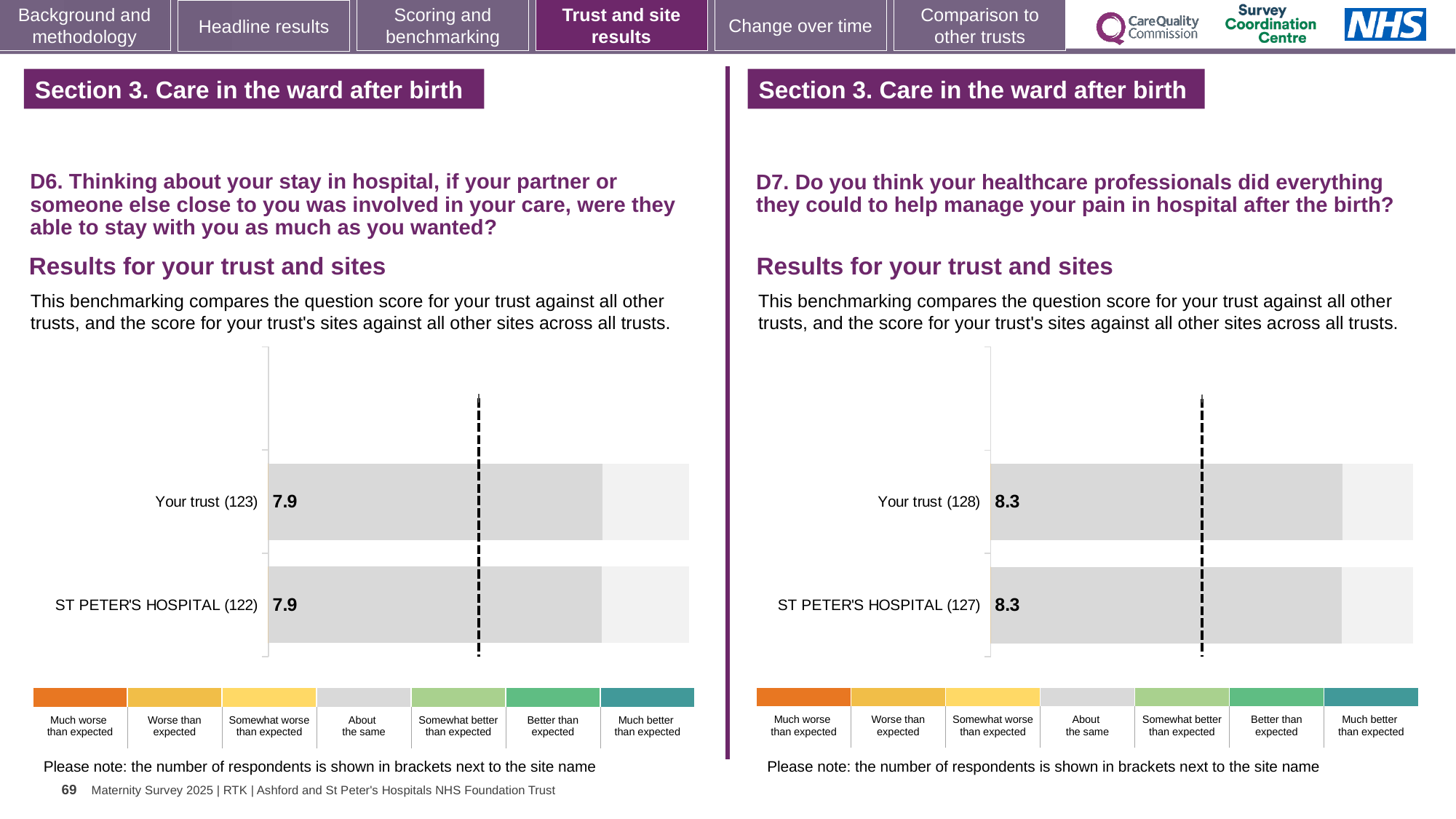
In the D6 chart on the left, how many respondents are shown in brackets for ST PETER'S HOSPITAL? 122 Is the score for Your trust in the D7 chart on the right larger or smaller than the score for Your trust in the D6 chart on the left? Larger What kind of chart is used for the D7 results on the right? Bar chart In the D7 chart on the right, what is the score for Your trust? 8.3 In the D7 chart on the right, what is the difference between the score for Your trust and the score for ST PETER'S HOSPITAL? 0 In the D7 chart on the right, how many respondents are shown in brackets for Your trust? 128 In the D6 chart on the left, what is the score for Your trust? 7.9 In the D6 chart on the left, what is the difference between the score for Your trust and the score for ST PETER'S HOSPITAL? 0 In the D7 chart on the right, what is the score for ST PETER'S HOSPITAL? 8.3 How many bars are plotted in the D7 chart on the right? 2 In the D6 chart on the left, what is the score for ST PETER'S HOSPITAL? 7.9 How many bars are plotted in the D6 chart on the left? 2